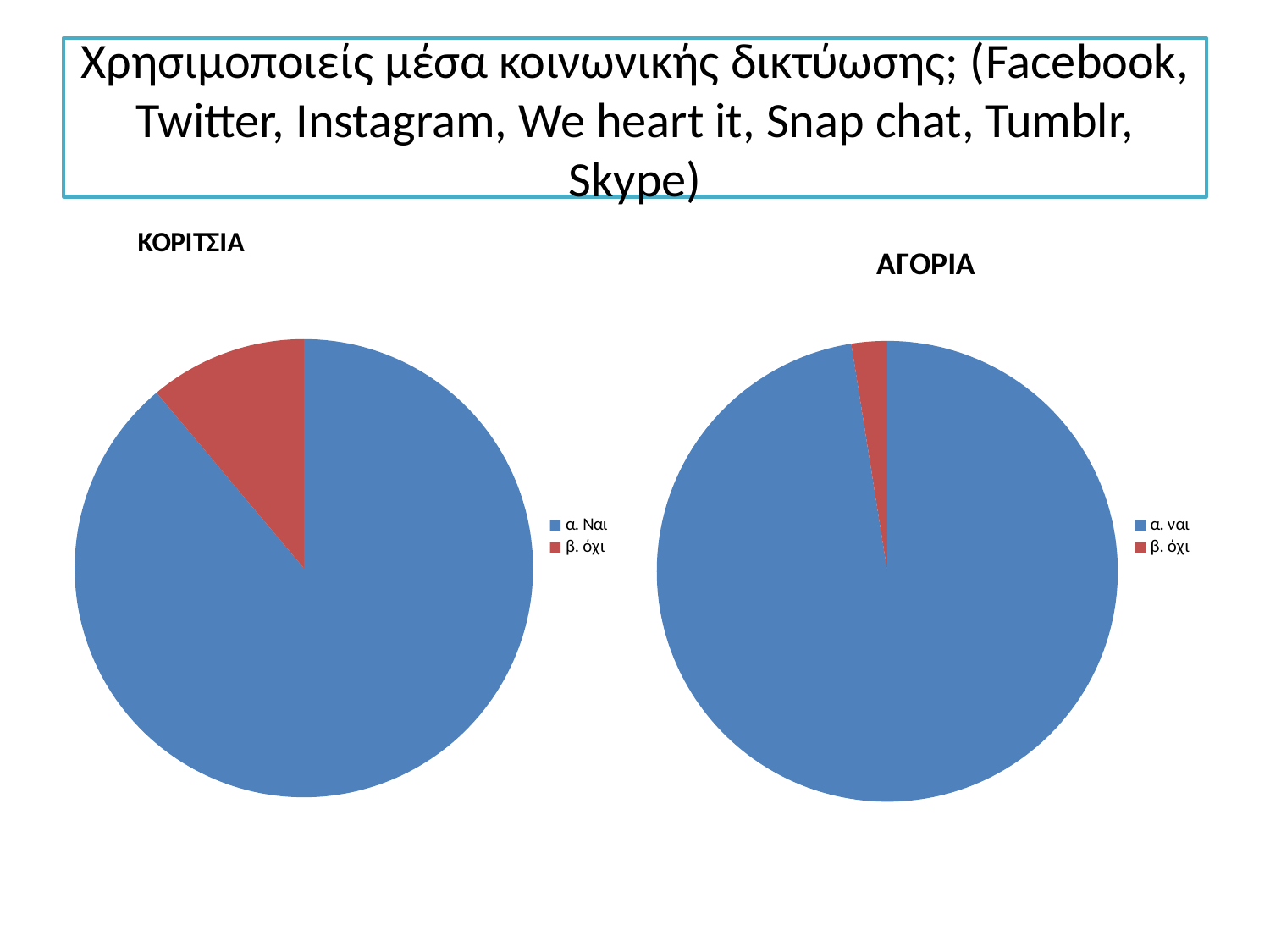
How many slices does the ΚΟΡΙΤΣΙΑ pie chart have? 2 How many entries does the legend of the ΑΓΟΡΙΑ chart list? 2 What kind of chart is the ΑΓΟΡΙΑ chart? pie chart In the ΚΟΡΙΤΣΙΑ chart, which slice is the largest? α. Ναι In the ΑΓΟΡΙΑ chart, which slice is the smallest? β. όχι Which chart has the larger β. όχι slice, ΚΟΡΙΤΣΙΑ or ΑΓΟΡΙΑ? ΚΟΡΙΤΣΙΑ What kind of chart is the ΚΟΡΙΤΣΙΑ chart? pie chart What colour is the β. όχι slice in the ΑΓΟΡΙΑ chart? red What is the title of the pie chart on the left? ΚΟΡΙΤΣΙΑ In the ΑΓΟΡΙΑ chart, which slice is the largest? α. ναι In the ΚΟΡΙΤΣΙΑ chart, which is larger, the α. Ναι slice or the β. όχι slice? α. Ναι In the ΚΟΡΙΤΣΙΑ chart, which slice is the smallest? β. όχι